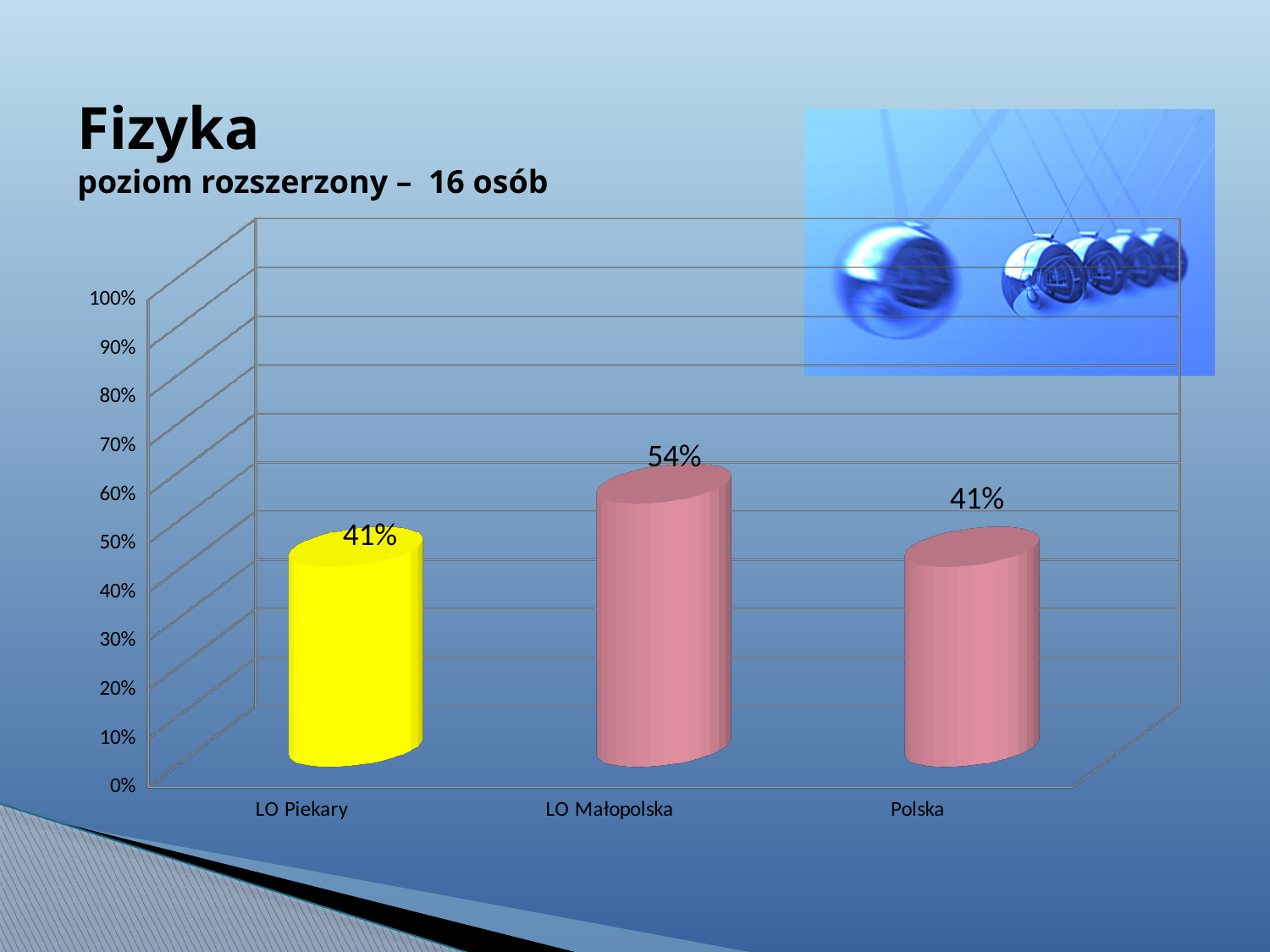
Which is larger, the value for LO Małopolska or the value for Polska? LO Małopolska Is the value for Polska greater or less than 50%? less Which category has the highest value? LO Małopolska How many categories are shown on the x axis? 3 What kind of chart is shown on the slide? bar chart What is the value for LO Piekary? 41% What colour is the bar for LO Piekary? yellow What is the value for LO Małopolska? 54% Is the value for LO Małopolska greater or less than 50%? greater What is the difference between the values for LO Małopolska and Polska? 13% What is the value for Polska? 41% What is the difference between the values for LO Małopolska and LO Piekary? 13%